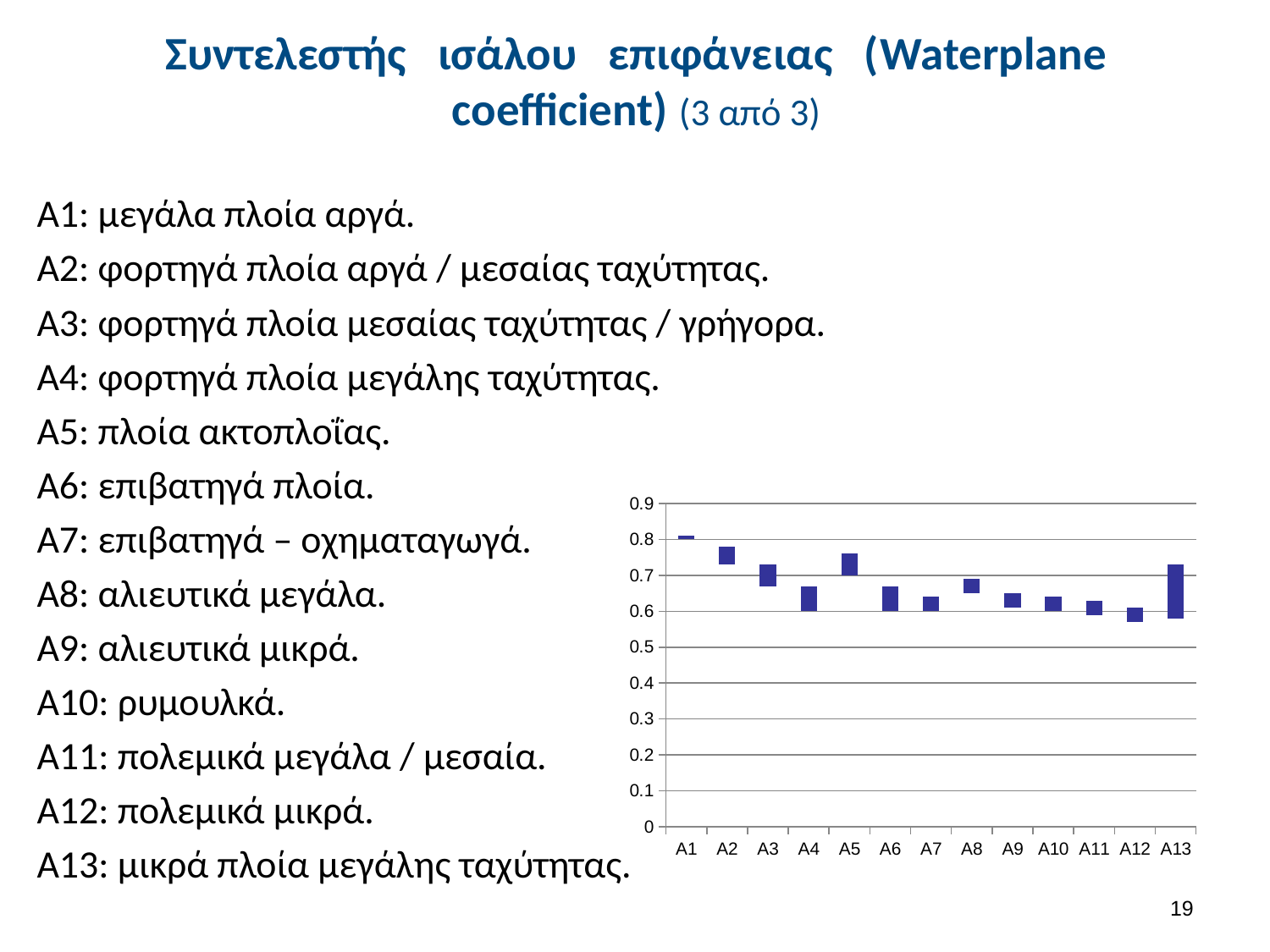
Is the value for A2 greater or less than 0.7? greater Is the value for A9 greater or less than 0.7? less Which has the higher value, A5 or A10? A5 What colour are the bars in the chart? blue Which has the higher value, A2 or A9? A2 How many categories are shown on the x axis of the chart? 13 What kind of chart is shown on the slide? bar chart Is the value for A10 greater or less than 0.8? less Do the values generally rise or fall from A1 to A12 along the x axis? fall What is the highest value shown on the y axis of the chart? 0.9